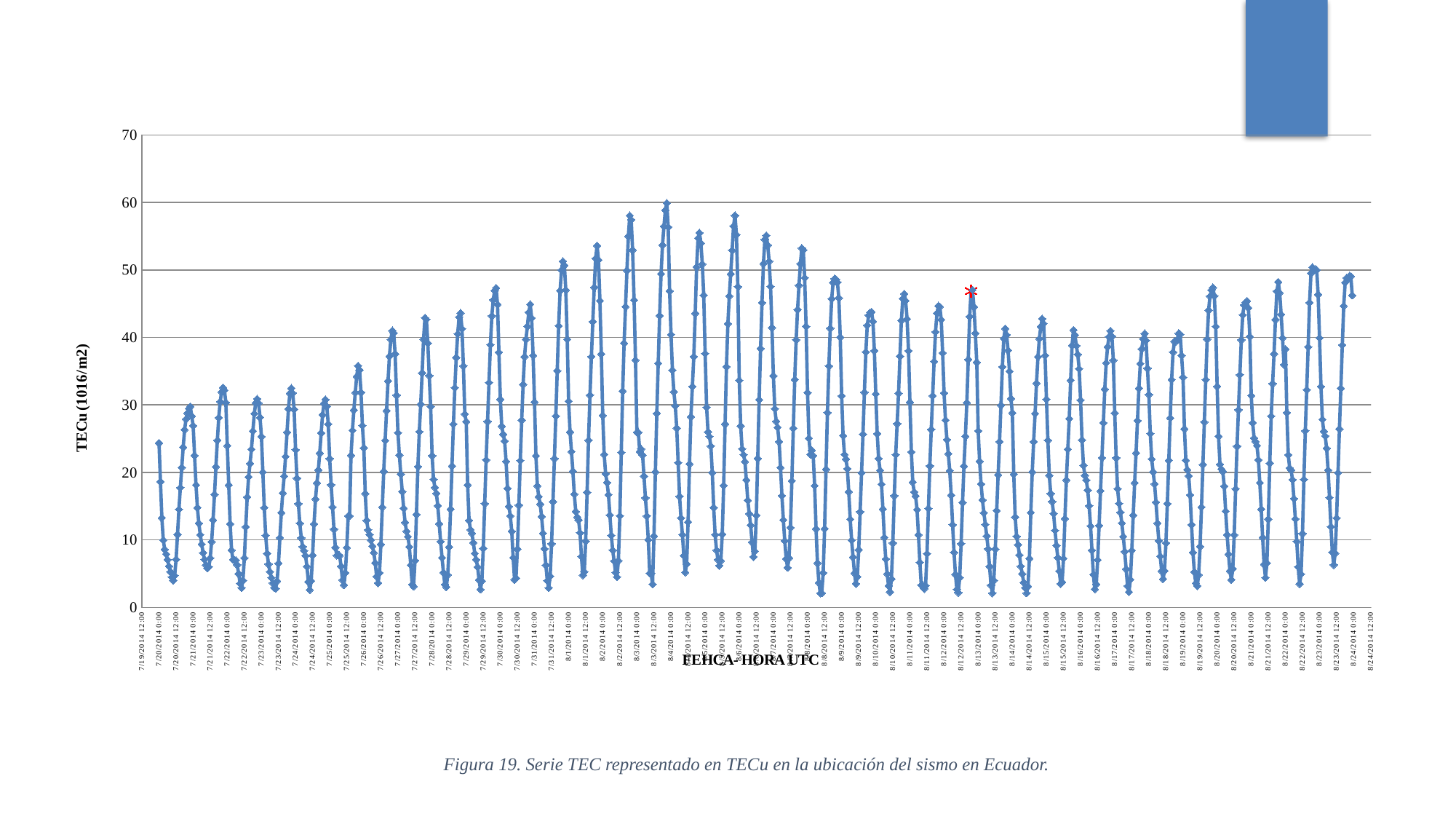
Do the daily peak values rise or fall between 7/20/2014 and 8/3/2014? rise Do the daily peak values rise or fall between 8/4/2014 and 8/8/2014? fall Is the peak value reached around 7/20/2014 12:00 greater or less than 20? greater What kind of chart is shown on the slide? line chart Which is larger, the peak value around 8/4/2014 0:00 or the peak value around 7/23/2014 0:00? the peak around 8/4/2014 0:00 Is the lowest value reached around 8/8/2014 12:00 greater or less than 10? less Is the peak value reached around 8/22/2014 12:00 greater or less than 40? greater What is the label of the vertical axis? TECu (1016/m2) What is the label of the horizontal axis? FECHA- HORA UTC